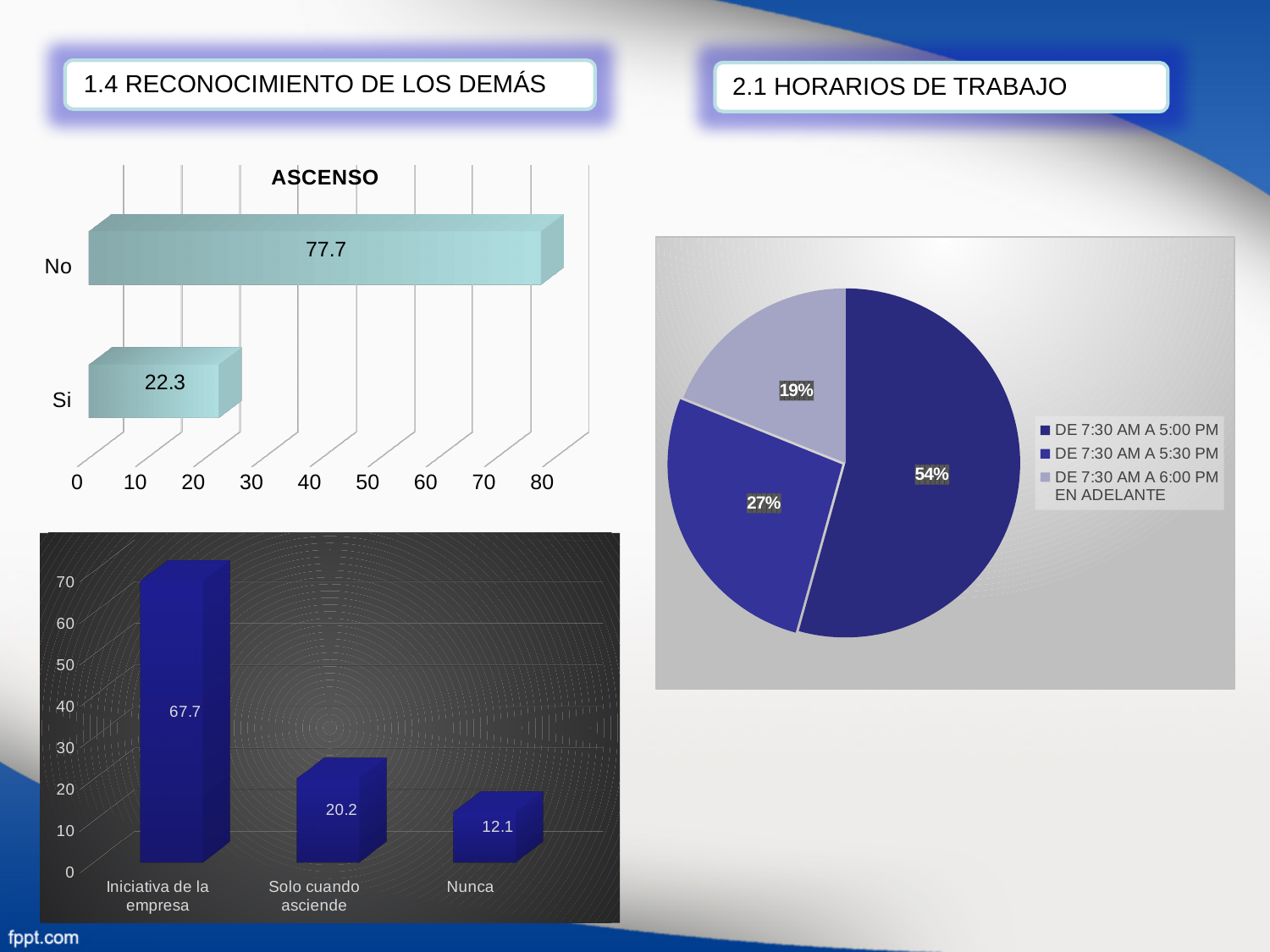
In the ASCENSO chart, what is the value for No? 77.7 What kind of chart is the ASCENSO chart? bar chart In the bottom-left bar chart, what is the value for Iniciativa de la empresa? 67.7 In the bottom-left bar chart, what is the difference between Solo cuando asciende and Nunca? 8.1 In the ASCENSO chart, what is the value for Si? 22.3 In the bottom-left bar chart, which category has the lowest value? Nunca In the pie chart under 2.1 HORARIOS DE TRABAJO, what share does DE 7:30 AM A 5:00 PM have? 54% In the bottom-left bar chart, how many categories are shown? 3 In the pie chart under 2.1 HORARIOS DE TRABAJO, how many entries does the legend list? 3 In the ASCENSO chart, what is the difference between the values for No and Si? 55.4 In the bottom-left bar chart, what is the value for Nunca? 12.1 In the pie chart under 2.1 HORARIOS DE TRABAJO, which slice is the smallest? DE 7:30 AM A 6:00 PM EN ADELANTE